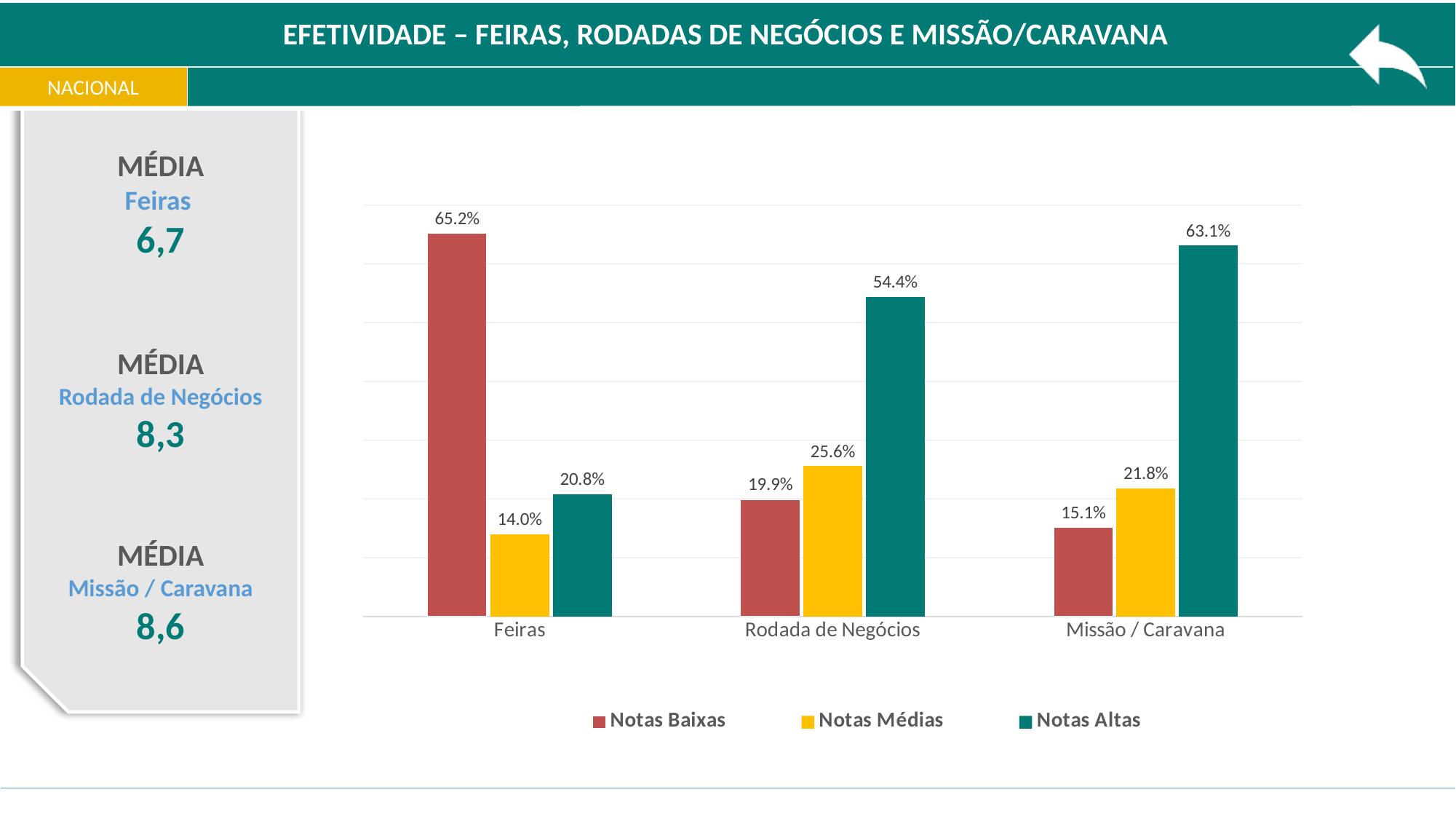
What is the difference between Notas Altas and Notas Baixas for Missão / Caravana? 48.0% What is the value of Notas Baixas for Feiras? 65.2% How many categories are shown on the x axis? 3 How many series does the legend list? 3 Do the Notas Baixas values rise or fall from Feiras to Missão / Caravana? Fall Which colour represents Notas Altas in the legend? Teal (green) What is the value of Notas Médias for Missão / Caravana? 21.8% What is the value of Notas Altas for Rodada de Negócios? 54.4% Which category has the highest value for Notas Altas? Missão / Caravana What kind of chart is shown on the slide? Bar chart Which is larger for Rodada de Negócios: Notas Baixas or Notas Médias? Notas Médias Which category has the lowest value for Notas Médias? Feiras